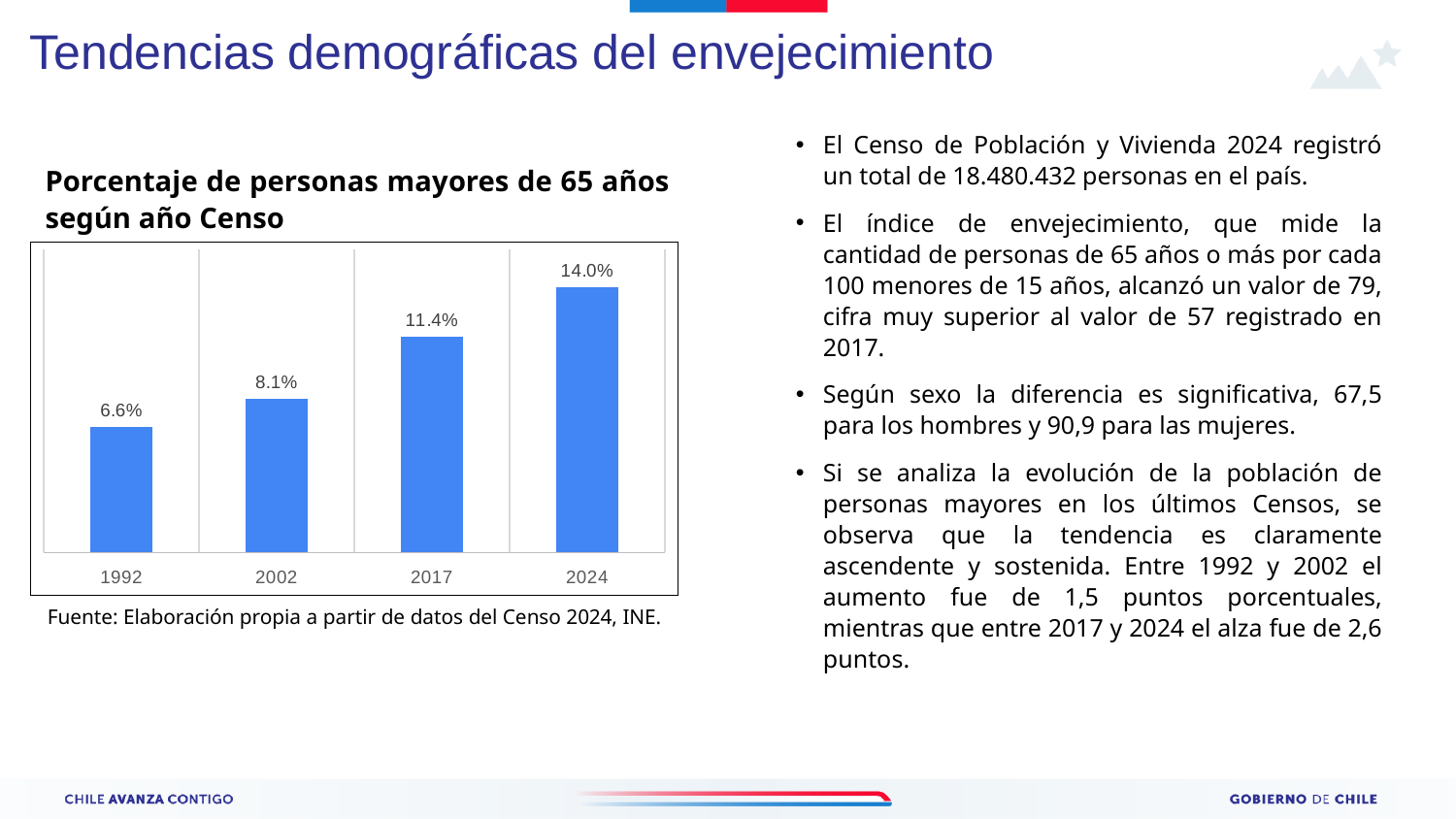
What type of chart is shown on the slide? Bar chart What is the difference in percentage points between the 2002 and 1992 values? 1.5 What is the difference in percentage points between the 2024 and 2017 values? 2.6 What is the percentage of people over 65 in the 1992 census? 6.6% Which census year has the highest percentage of people over 65? 2024 Which census year has the lowest percentage of people over 65? 1992 What is the percentage of people over 65 in the 2024 census? 14.0% Which is larger, the value for 2002 or the value for 2017? 2017 Do the values rise or fall from 1992 to 2024? Rise How many census years are shown in the chart? 4 What is the percentage of people over 65 in the 2002 census? 8.1% What is the percentage of people over 65 in the 2017 census? 11.4%